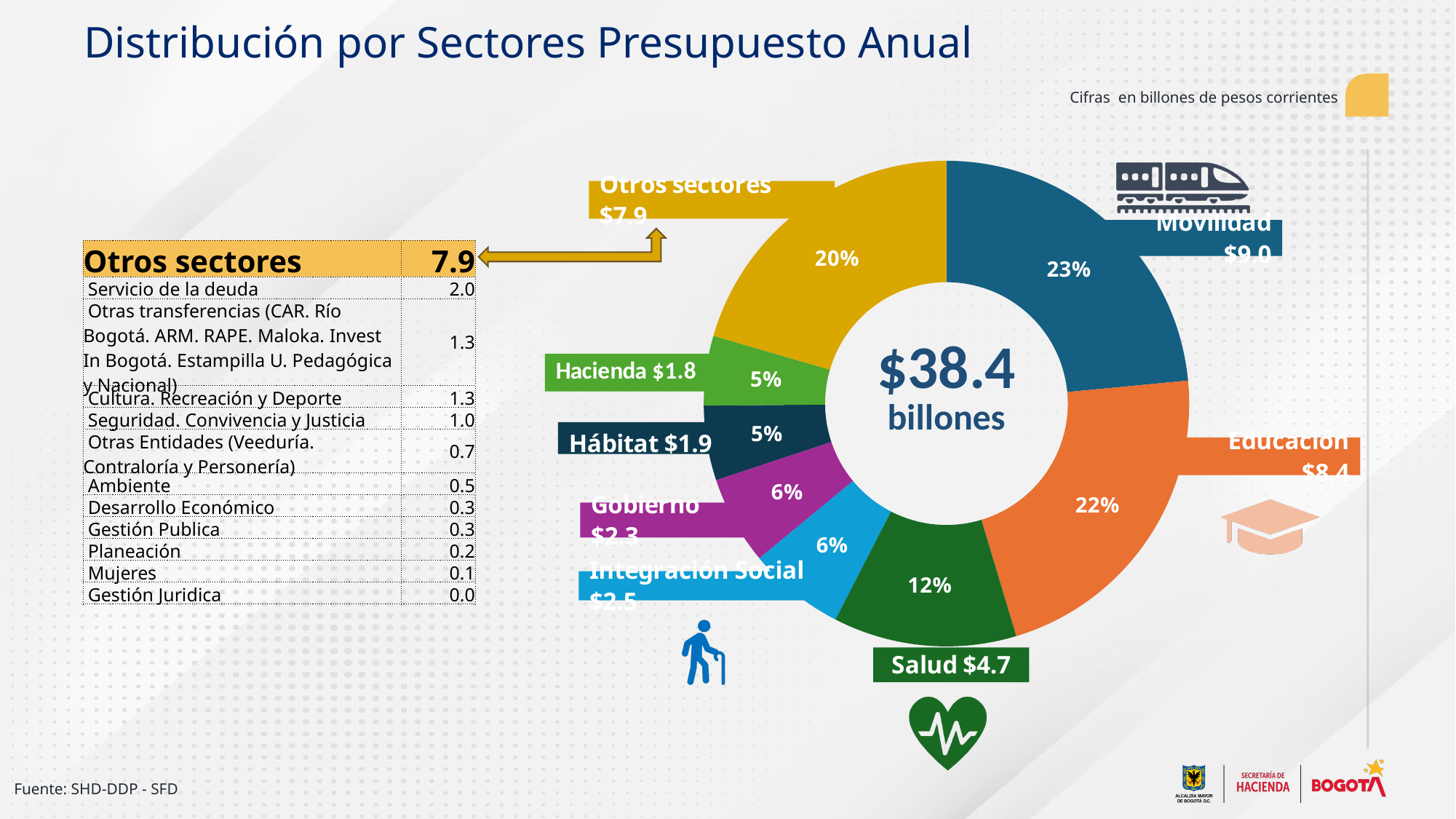
What kind of chart is shown on the slide? Pie chart (donut) In the table, what is the value for Servicio de la deuda within Otros sectores? 2.0 What percentage of the annual budget does Movilidad represent in the pie chart? 23% What is the value shown for Salud in the pie chart? $4.7 Which sector has the largest share of the pie chart? Movilidad What is the difference between the Movilidad value and the Educación value in the pie chart? $0.6 How many sectors (slices) are shown in the pie chart? 8 What total value is shown in the center of the donut chart? $38.4 billones Which sector has the smallest value shown in the pie chart? Hacienda What percentage share does Educación have in the pie chart? 22% Which is larger in the pie chart, Integración Social or Gobierno? Integración Social What percentage of the pie chart corresponds to Otros sectores? 20%